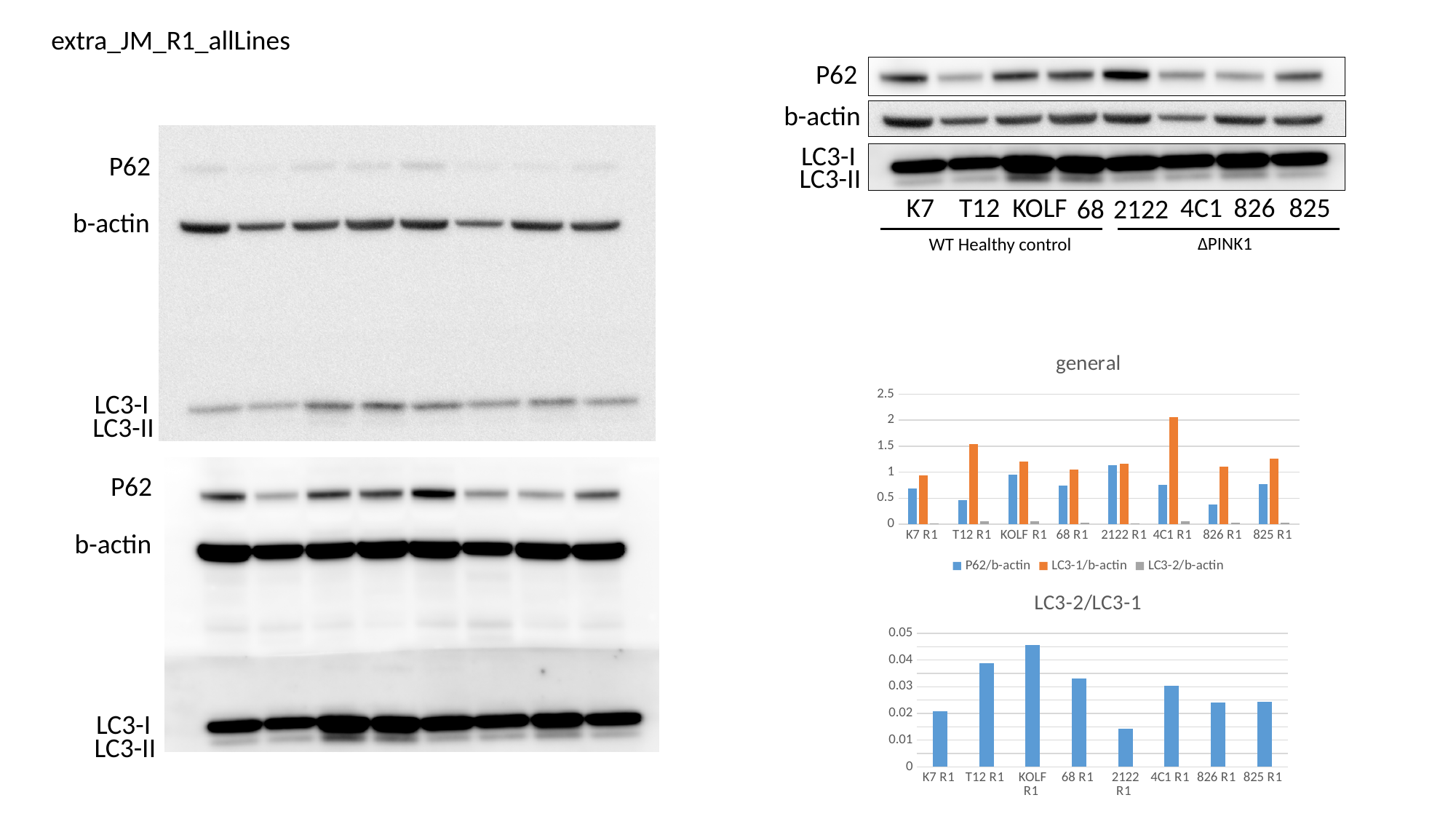
In the chart titled "general", which series is shown in orange? LC3-1/b-actin In the chart titled "general", which category has the highest P62/b-actin value? 2122 R1 In the chart titled "LC3-2/LC3-1", which category has the highest value? KOLF R1 In the chart titled "general", is the P62/b-actin value for 826 R1 greater or less than 0.5? less In the chart titled "general", how many categories are shown on the x axis? 8 In the chart titled "LC3-2/LC3-1", is the value for 2122 R1 greater or less than 0.02? less In the chart titled "general", how many series does the legend list? 3 In the chart titled "general", is the LC3-1/b-actin value for 4C1 R1 greater or less than 1.5? greater In the chart titled "LC3-2/LC3-1", which category has the lowest value? 2122 R1 In the chart titled "general", which category has the highest LC3-1/b-actin value? 4C1 R1 In the chart titled "general", which category has the lowest P62/b-actin value? 826 R1 In the chart titled "LC3-2/LC3-1", which is larger, the value for K7 R1 or the value for 4C1 R1? 4C1 R1